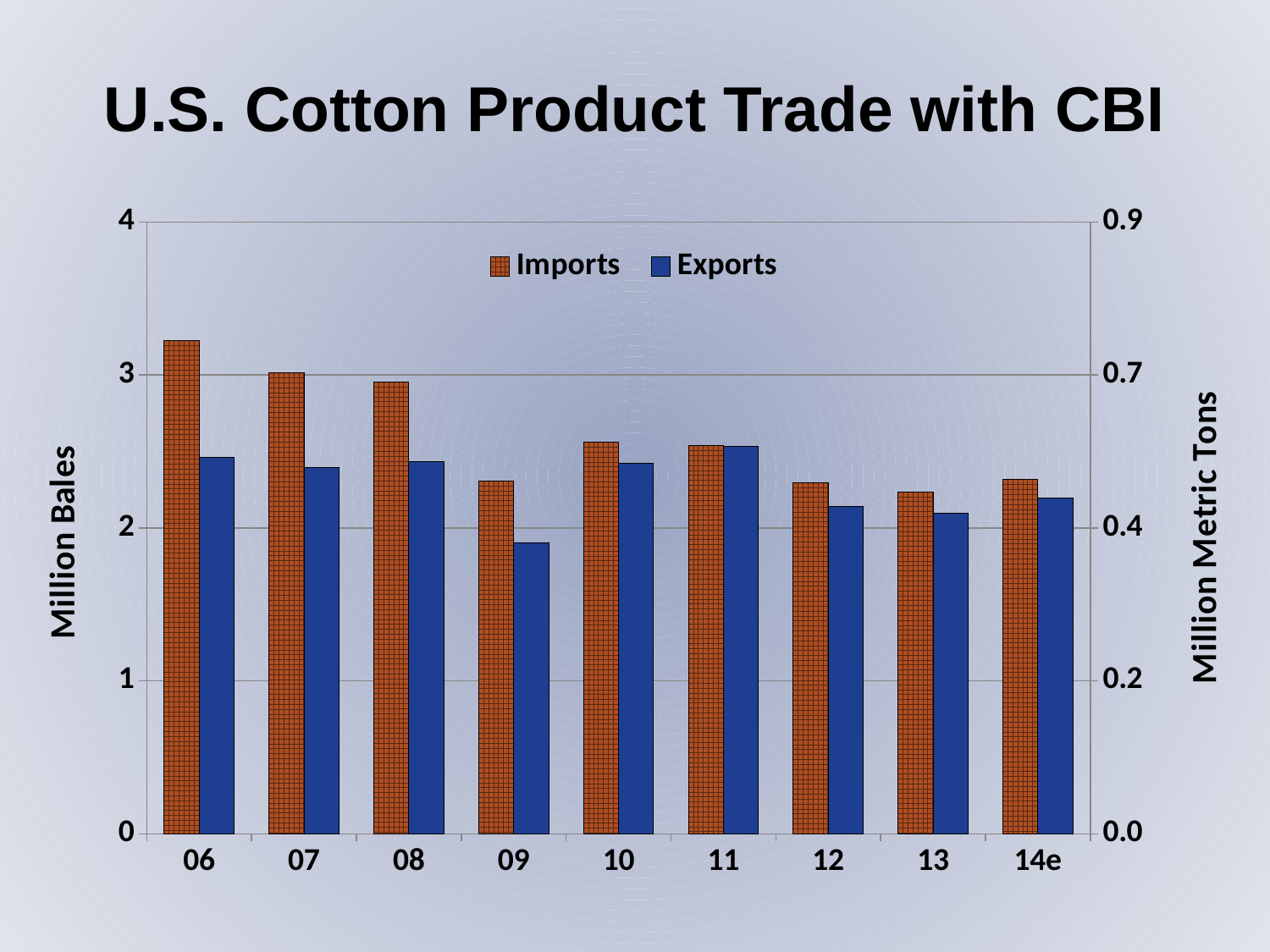
Is the Exports value for 09 greater or less than 2 million bales? less In which year are Exports lowest? 09 Is the Imports value for 09 greater or less than 2 million bales? greater How many series does the legend list? 2 Do Imports rise or fall from 06 to 09? fall What kind of chart is shown on the slide? bar chart Is the Imports value for 06 greater or less than 3 million bales? greater In which year are Imports highest? 06 How many years are shown along the x axis? 9 What is the label of the right-hand vertical axis? Million Metric Tons Which year has the larger Exports value, 09 or 10? 10 In 06, which is larger, Imports or Exports? Imports